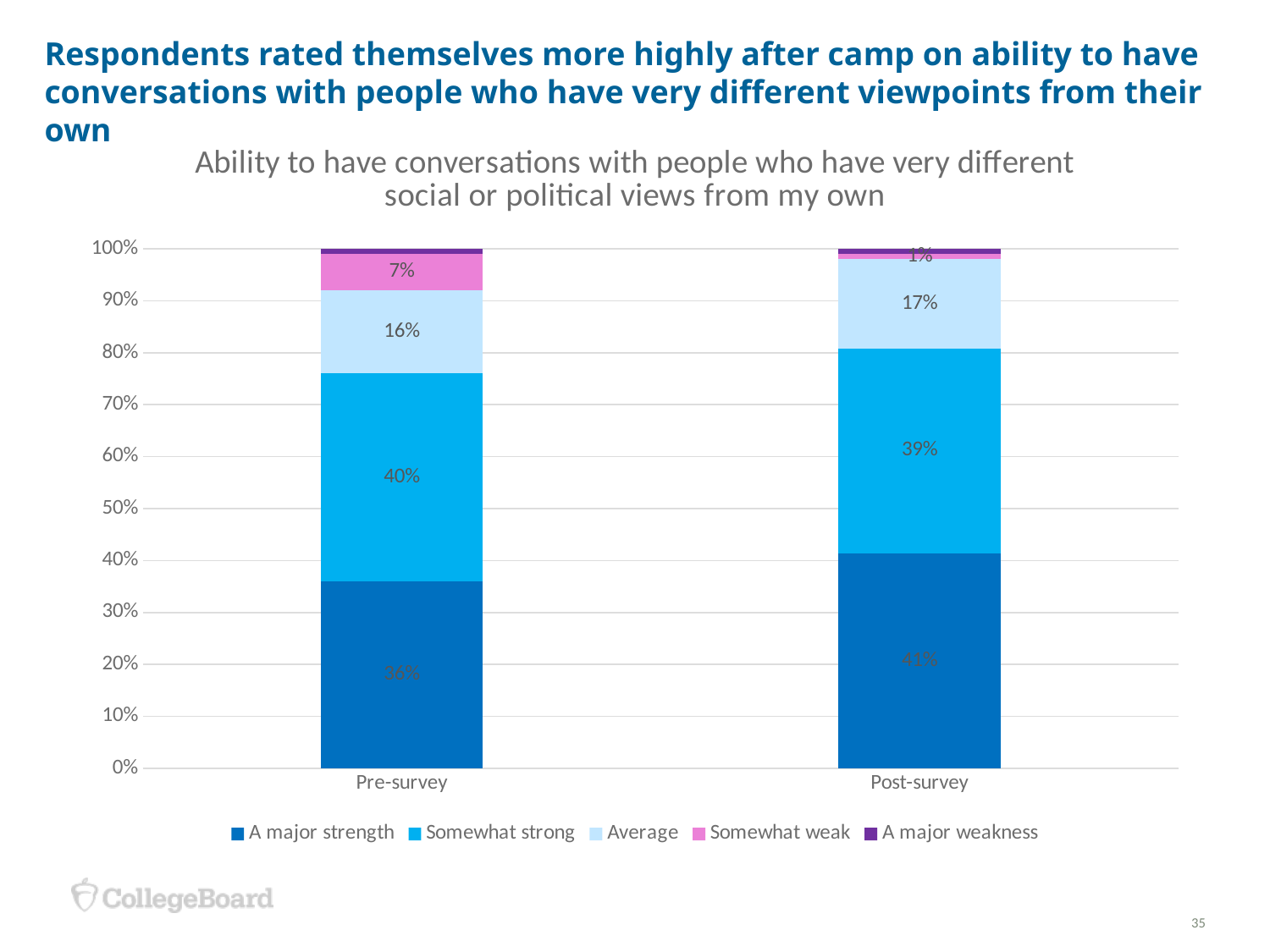
What is the 'Somewhat weak' value for the Pre-survey bar? 7% What kind of chart is shown on the slide? Stacked bar chart Does the 'A major strength' share rise or fall from Pre-survey to Post-survey? Rise What is the title of the chart? Ability to have conversations with people who have very different social or political views from my own What percentage of Post-survey respondents rated this ability as 'A major strength'? 41% How many series does the legend list? 5 How many bars (survey categories) are shown on the x axis? 2 By how many percentage points did the 'A major strength' share increase from Pre-survey to Post-survey? 5 percentage points Which survey has the larger 'Somewhat strong' share, Pre-survey or Post-survey? Pre-survey What is the 'Somewhat strong' value for the Pre-survey bar? 40% What is the 'Average' value for the Post-survey bar? 17% What percentage of Pre-survey respondents rated this ability as 'A major strength'? 36%